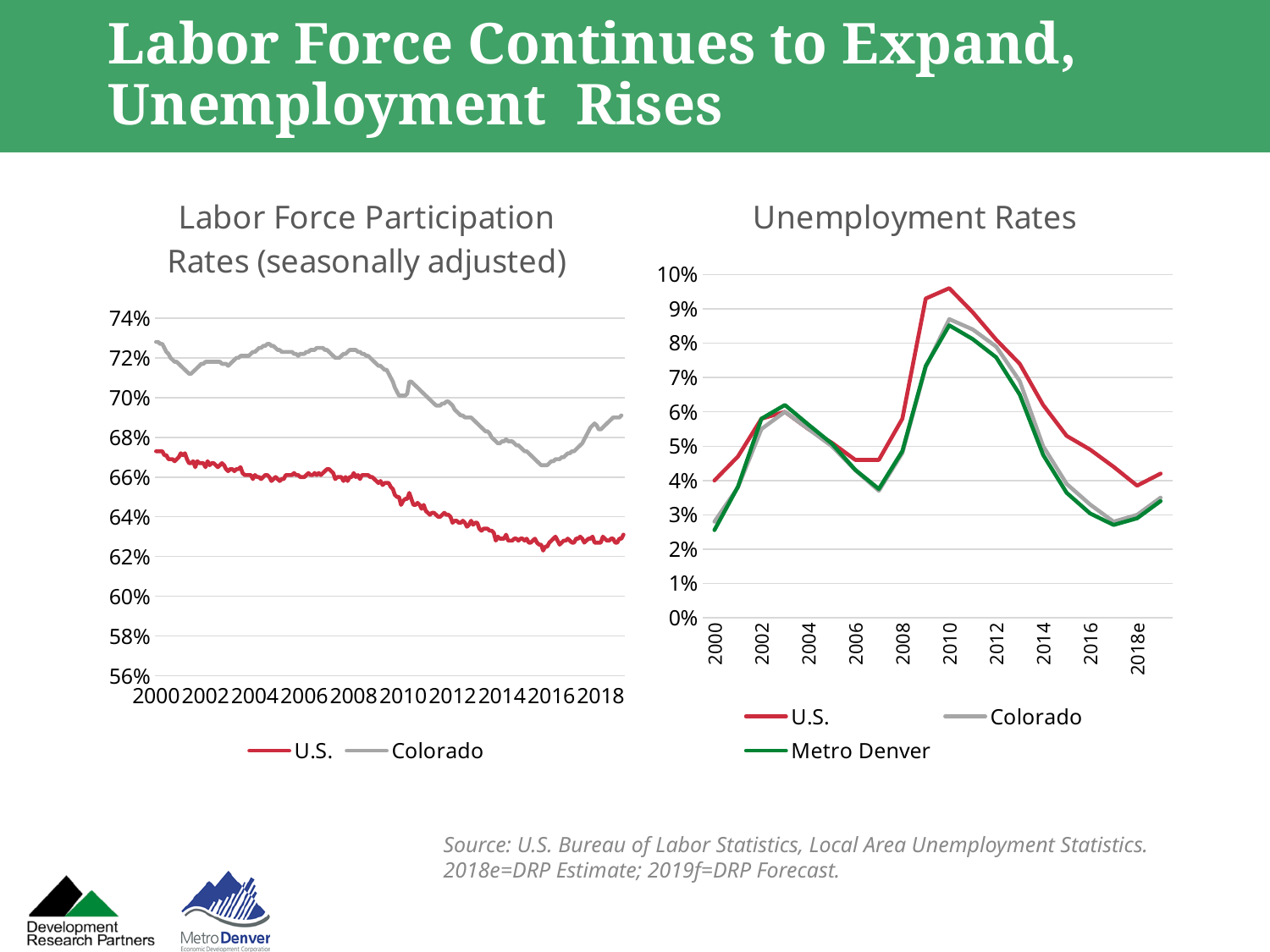
How many series does the legend of the Unemployment Rates chart list? 3 In the Unemployment Rates chart, which series has the higher value in 2010, U.S. or Metro Denver? U.S. In the Labor Force Participation Rates chart, is the Colorado value in 2000 greater or less than 72%? greater In the Unemployment Rates chart, is the Metro Denver value in 2000 greater or less than 3%? less Which series in the Unemployment Rates chart is drawn in green? Metro Denver What kind of chart is the Labor Force Participation Rates chart on the left? line chart In the Labor Force Participation Rates chart, which series is higher throughout the period, U.S. or Colorado? Colorado How many series does the legend of the Labor Force Participation Rates chart list? 2 In the Labor Force Participation Rates chart, is the U.S. value in 2018 greater or less than 64%? less In the Labor Force Participation Rates chart, does the U.S. line generally rise or fall from 2000 to 2018? fall In the Unemployment Rates chart, do the lines rise or fall between 2007 and 2010? rise